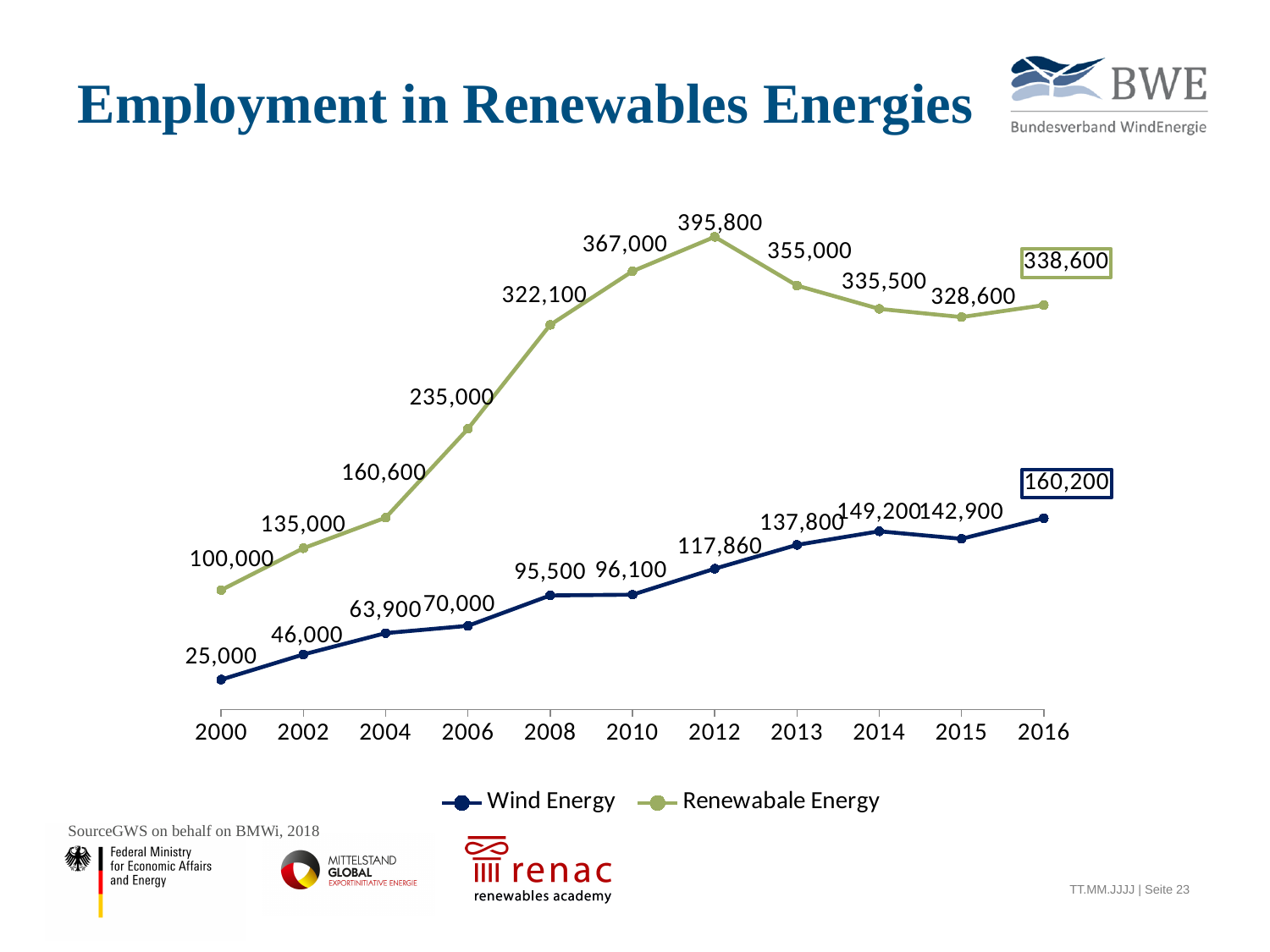
In which year is the Wind Energy value lowest? 2000 How many years are plotted along the x axis? 11 What is the Wind Energy value for 2016? 160,200 What is the Wind Energy value for 2012? 117,860 Which is larger: the Wind Energy value in 2014 or in 2015? 2014 What is the difference between the Renewabale Energy and Wind Energy values in 2016? 178,400 What is the Renewabale Energy value for 2006? 235,000 What is the title of the chart on the slide? Employment in Renewables Energies In which year does the Renewabale Energy series reach its highest value? 2012 What kind of chart is shown on the slide? Line chart Does the Wind Energy series generally rise or fall from 2000 to 2016? Rise How many series does the legend list? 2